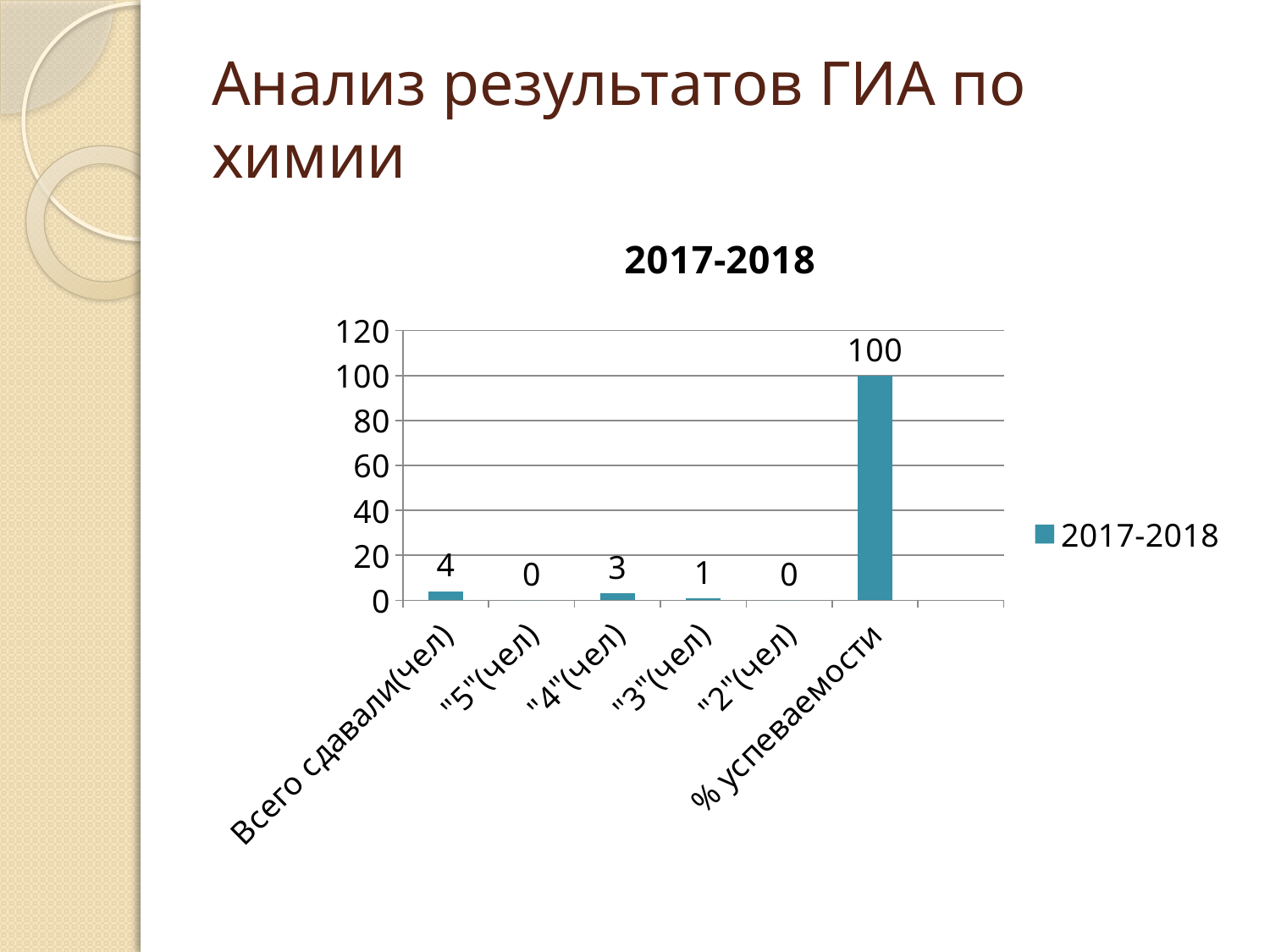
What is the value for "Всего сдавали(чел)"? 4 What is the value for "5"(чел)? 0 How many series does the legend list? 1 How many categories are shown on the x axis? 6 Which is larger, the value for "4"(чел) or the value for "3"(чел)? "4"(чел) Is the value for "% успеваемости" greater or less than 80? greater What is the value for "% успеваемости"? 100 Which category has the highest value? % успеваемости What kind of chart is shown? bar chart What is the value for "4"(чел)? 3 What is the difference between the values for "Всего сдавали(чел)" and "4"(чел)? 1 What is the value for "3"(чел)? 1